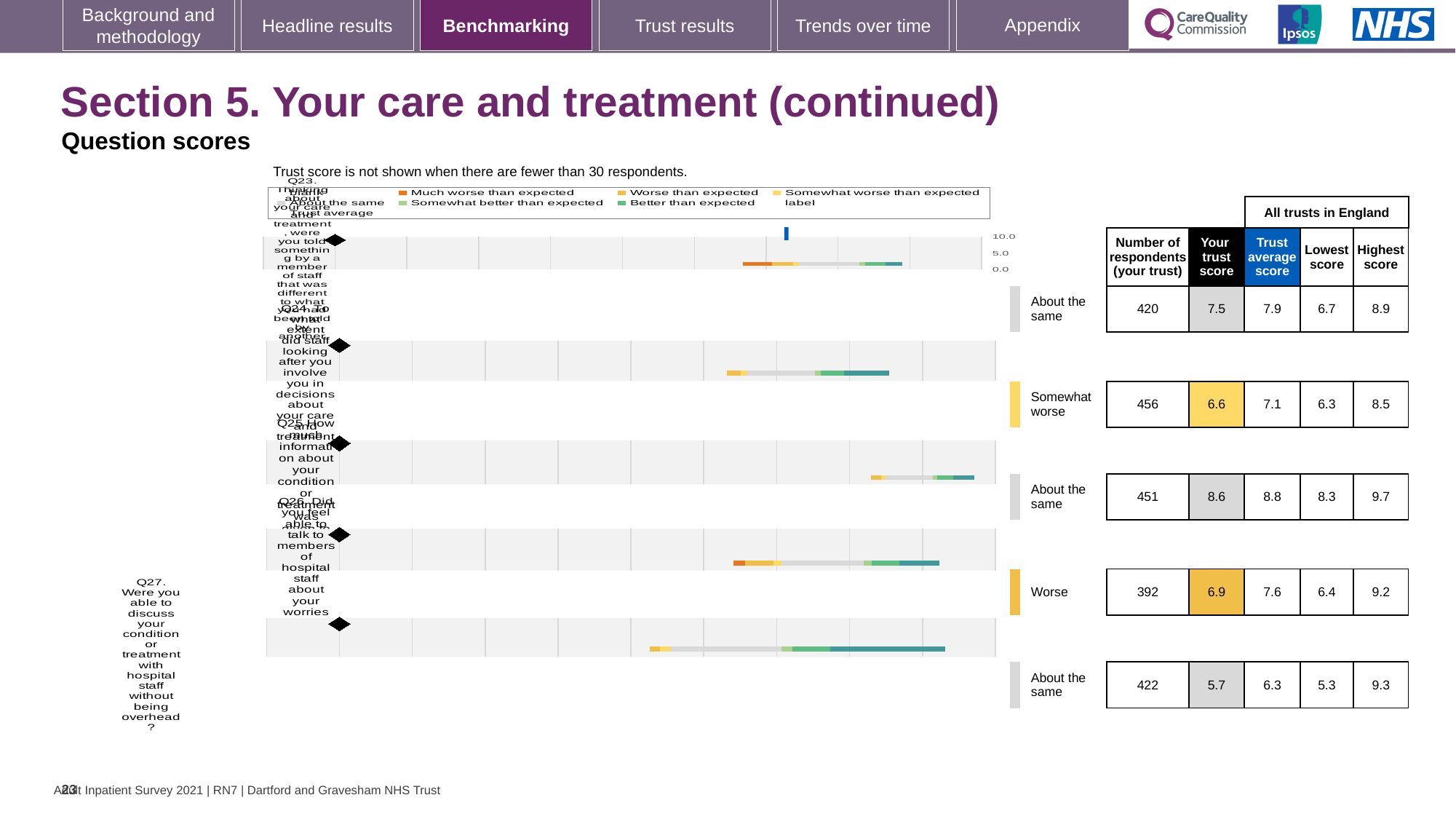
For Q24, what is the difference between the trust average score and your trust score? 0.5 How many respondents (your trust) are shown for Q27 (discussing your condition without being overheard)? 422 Which question has the highest 'Your trust score'? Q25 What is the highest score across all trusts in England for Q25? 9.7 What is the lowest score across all trusts in England for Q27? 5.3 How many questions are plotted on the chart? 5 For Q26, which is larger: your trust score or the trust average score? Trust average score What benchmark category is shown for Q26 (talking to staff about your worries)? Worse Which question has the lowest 'Your trust score'? Q27 Which question has the largest number of respondents? Q24 What is the 'Your trust score' for Q23 (being told something different by staff)? 7.5 What kind of chart is used to show the question scores? Bar chart